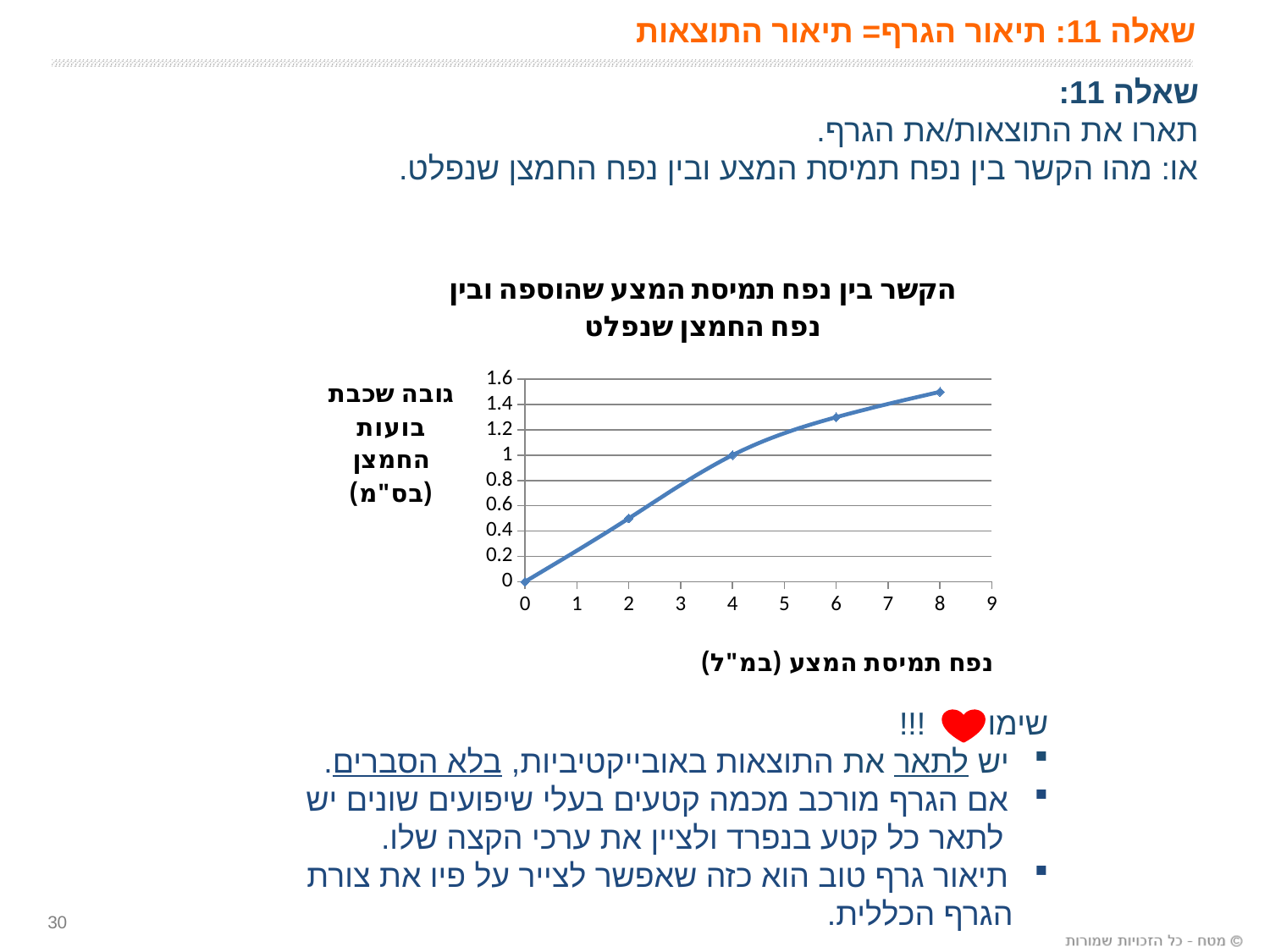
What is the value of the oxygen bubble layer height when the substrate solution volume is 4 ml? 1 What is the value of the oxygen bubble layer height when the substrate solution volume is 0 ml? 0 At which substrate solution volume is the oxygen bubble layer height highest? 8 Is the value at a substrate solution volume of 2 ml greater or less than 0.6? less Is the value at a substrate solution volume of 8 ml greater or less than 1.4? greater Is the value at a substrate solution volume of 6 ml greater or less than 1.2? greater What is the label of the x axis of the chart? נפח תמיסת המצע (במ"ל) How many data points are plotted on the line? 5 What kind of chart is shown on the slide? line chart Which has a larger value: the point at 6 ml or the point at 2 ml? 6 ml Do the values rise or fall as the substrate solution volume increases along the x axis? rise At which substrate solution volume is the oxygen bubble layer height lowest? 0